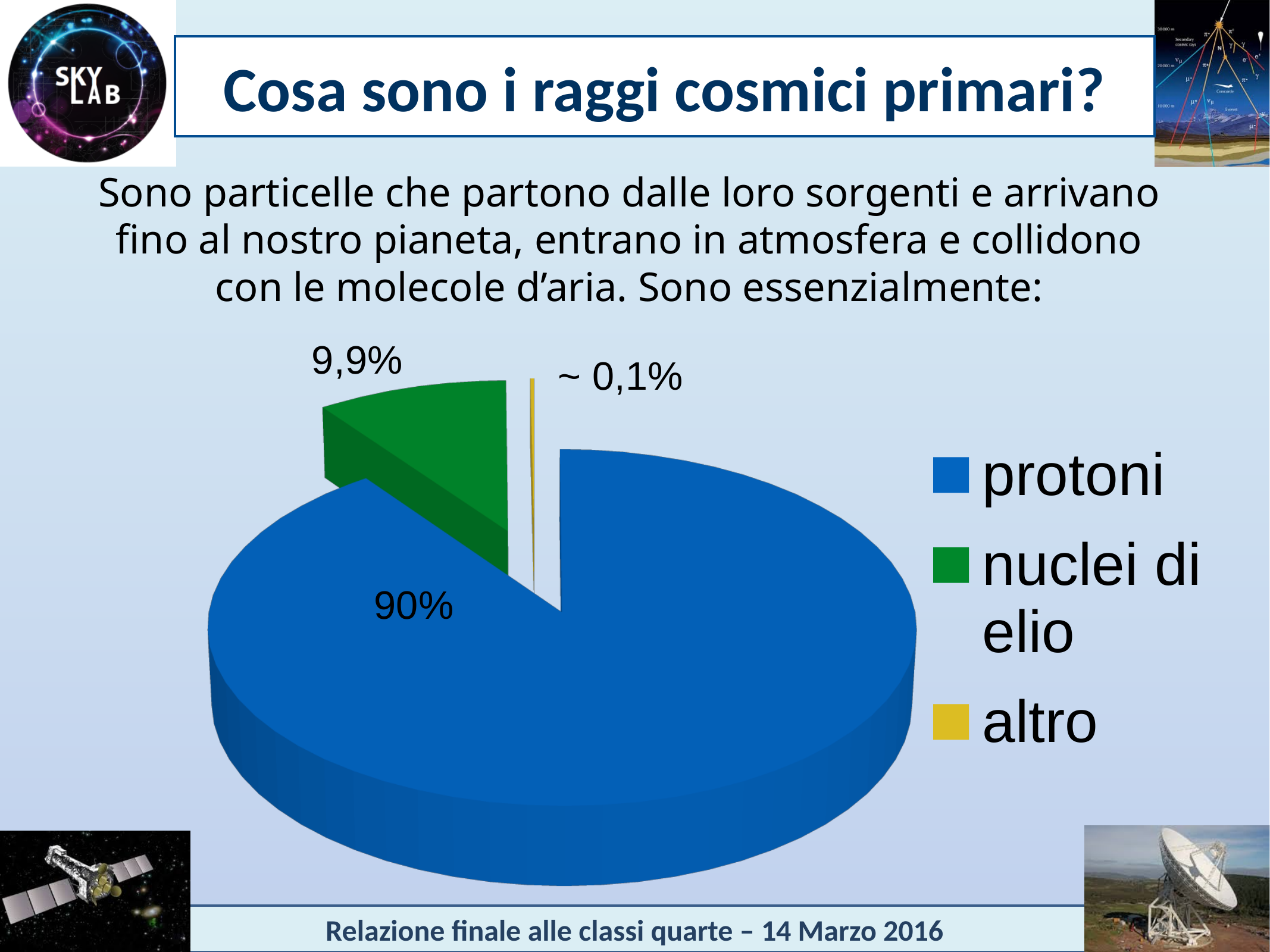
What is the difference between the protoni share and the nuclei di elio share? 80,1% Which slice is larger, nuclei di elio or altro? nuclei di elio What share of the pie does the protoni slice represent? 90% What kind of chart is shown on the slide? pie chart Which slice is larger, protoni or nuclei di elio? protoni How many categories does the pie chart show? 3 How many entries does the legend list? 3 What percentage of the pie chart is labelled for nuclei di elio? 9,9% What colour is the slice for nuclei di elio? green Which category has the smallest slice of the pie chart? altro Which category has the largest slice of the pie chart? protoni What percentage of the pie chart is labelled for protoni? 90%